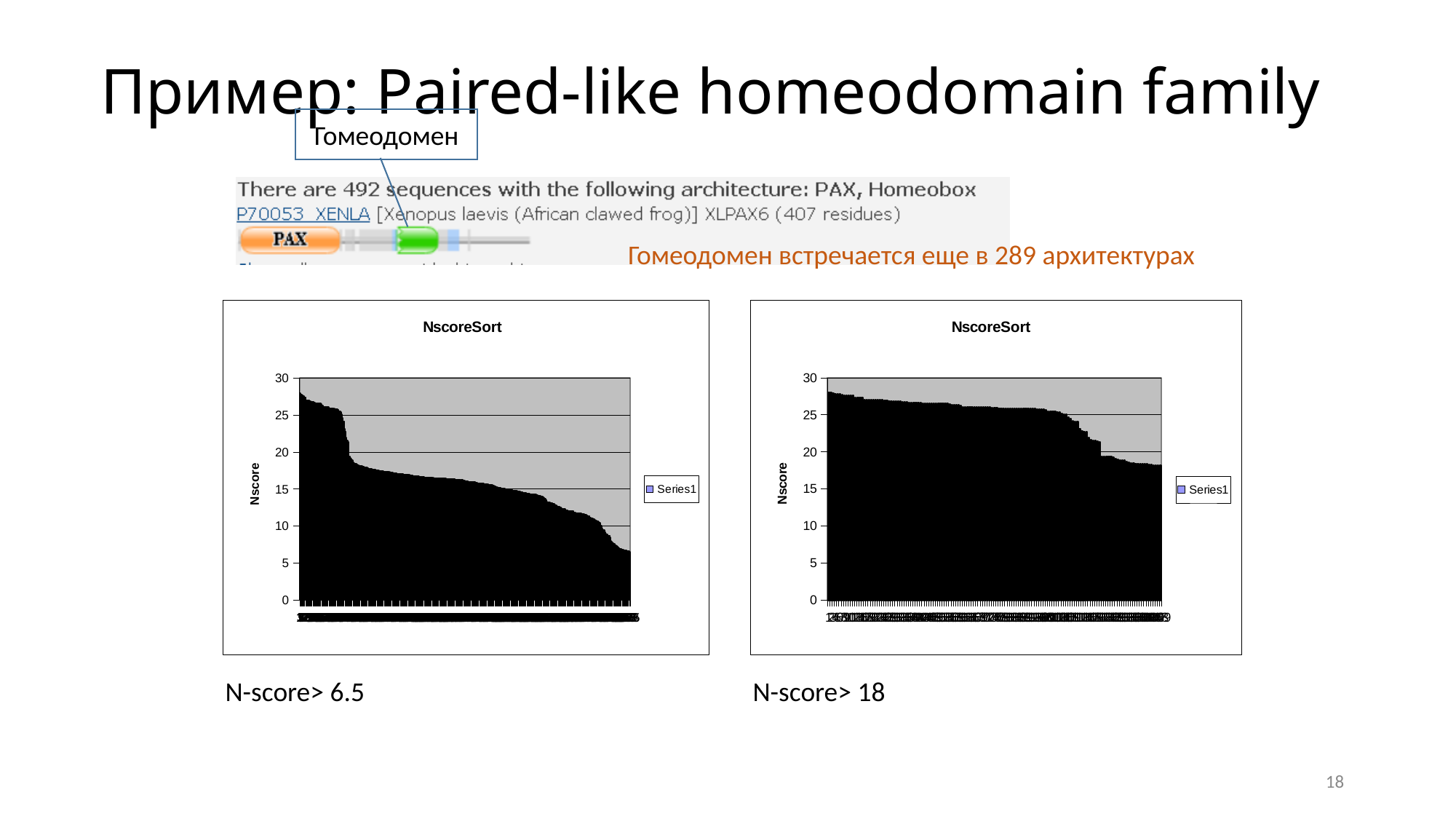
Which chart has the lower minimum value, the left chart or the right chart? the left chart What kind of chart is the left chart titled NscoreSort? bar chart In the right chart, is the value of the rightmost (lowest) bar greater or less than 15? greater In the right chart, do the values rise or fall from left to right along the x axis? fall How many series does the legend of the right chart list? 1 How many series does the legend of the left chart list? 1 In the left chart, is the value of the leftmost (highest) bar greater or less than 25? greater In the left chart, is the value of the rightmost (lowest) bar greater or less than 10? less In the left chart, do the values rise or fall from left to right along the x axis? fall What kind of chart is the right chart titled NscoreSort? bar chart What is the label of the y axis on the left chart? Nscore